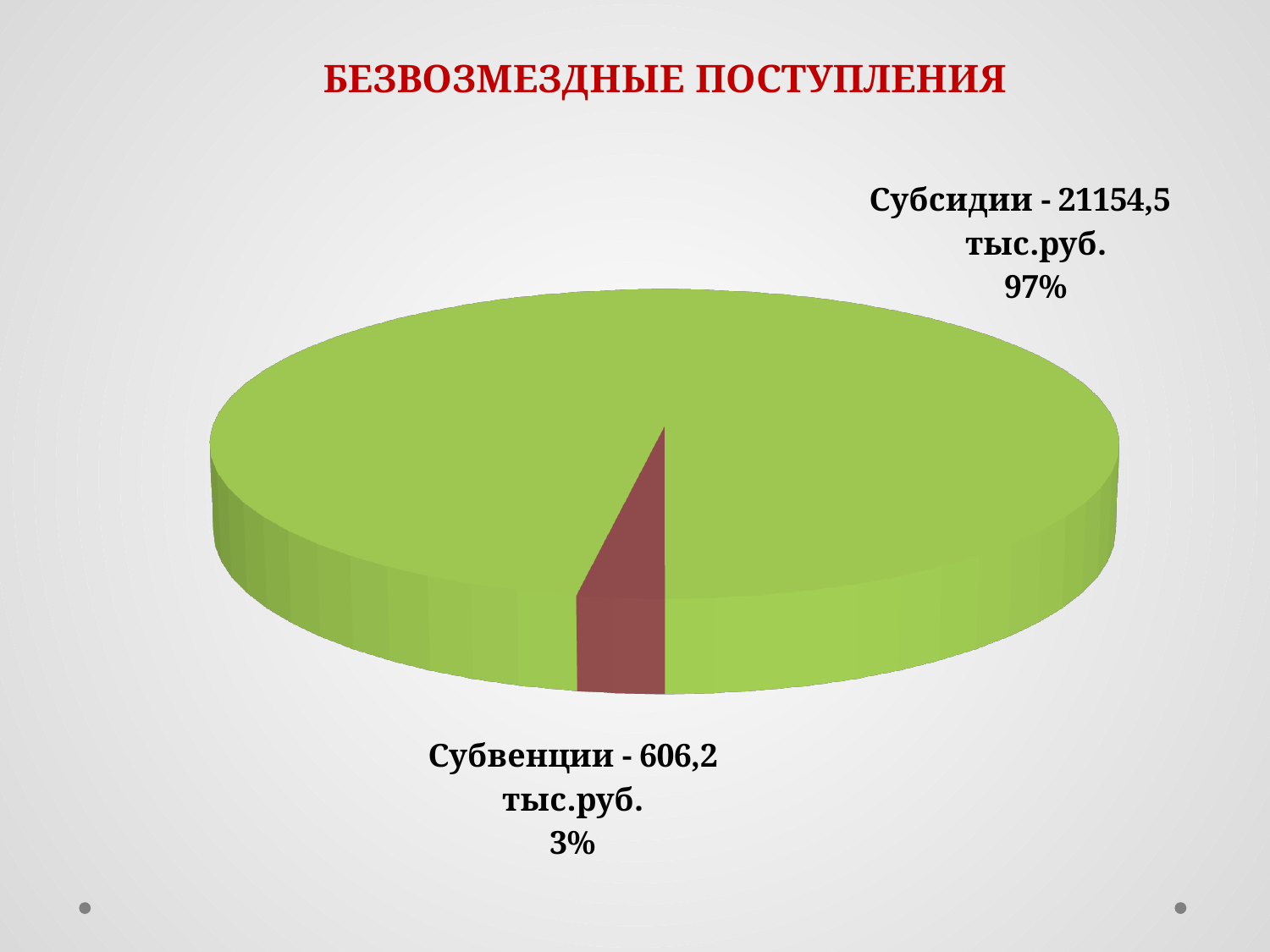
What is the title of the chart? БЕЗВОЗМЕЗДНЫЕ ПОСТУПЛЕНИЯ What colour is the Субвенции slice? dark red Which category has the largest slice? Субсидии Which category has the smallest slice? Субвенции What share of the pie does Субсидии represent? 97% What kind of chart is shown on the slide? pie chart What is the value for Субсидии? 21154,5 тыс.руб. What is the difference between the values for Субсидии and Субвенции? 20548,3 тыс.руб. What share of the pie does Субвенции represent? 3% What is the value for Субвенции? 606,2 тыс.руб. How many slices does the pie chart have? 2 Which is larger, Субсидии or Субвенции? Субсидии